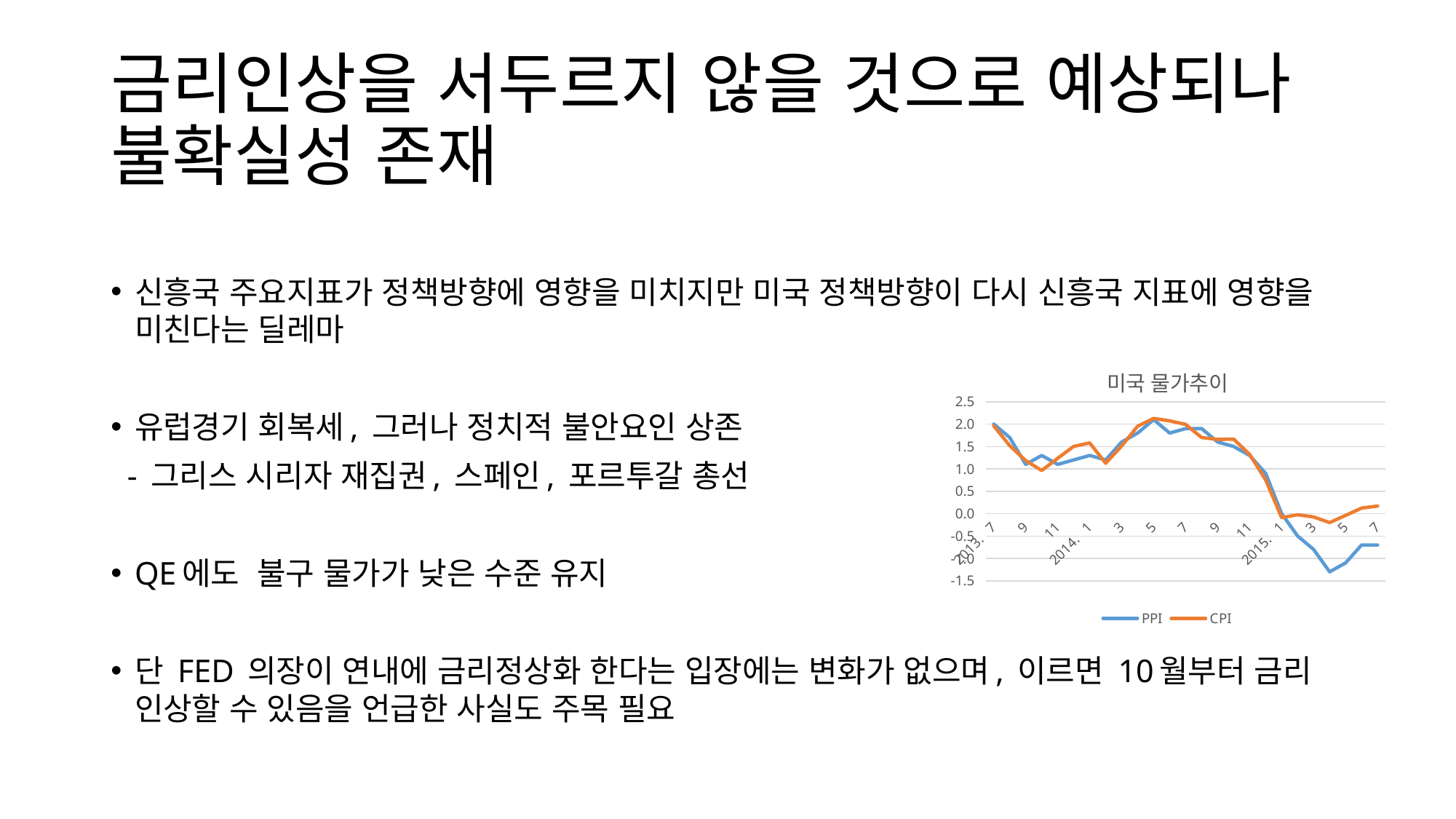
Which series reaches the lowest value in the chart? PPI Is the PPI value at 2015.5 greater or less than -0.5? less At 2015.5, which series has the higher value, PPI or CPI? CPI How many series does the legend of the chart list? 2 At 2015.3, which series has the higher value, PPI or CPI? CPI Is the CPI value at 2015.7 greater or less than 0.5? less Is the CPI value at 2015.5 greater or less than -0.5? greater What kind of chart is shown on the slide? line chart Which series is drawn in orange in the chart? CPI What is the title of the chart? 미국 물가추이 Do the PPI values rise or fall between 2014.11 and 2015.5? fall